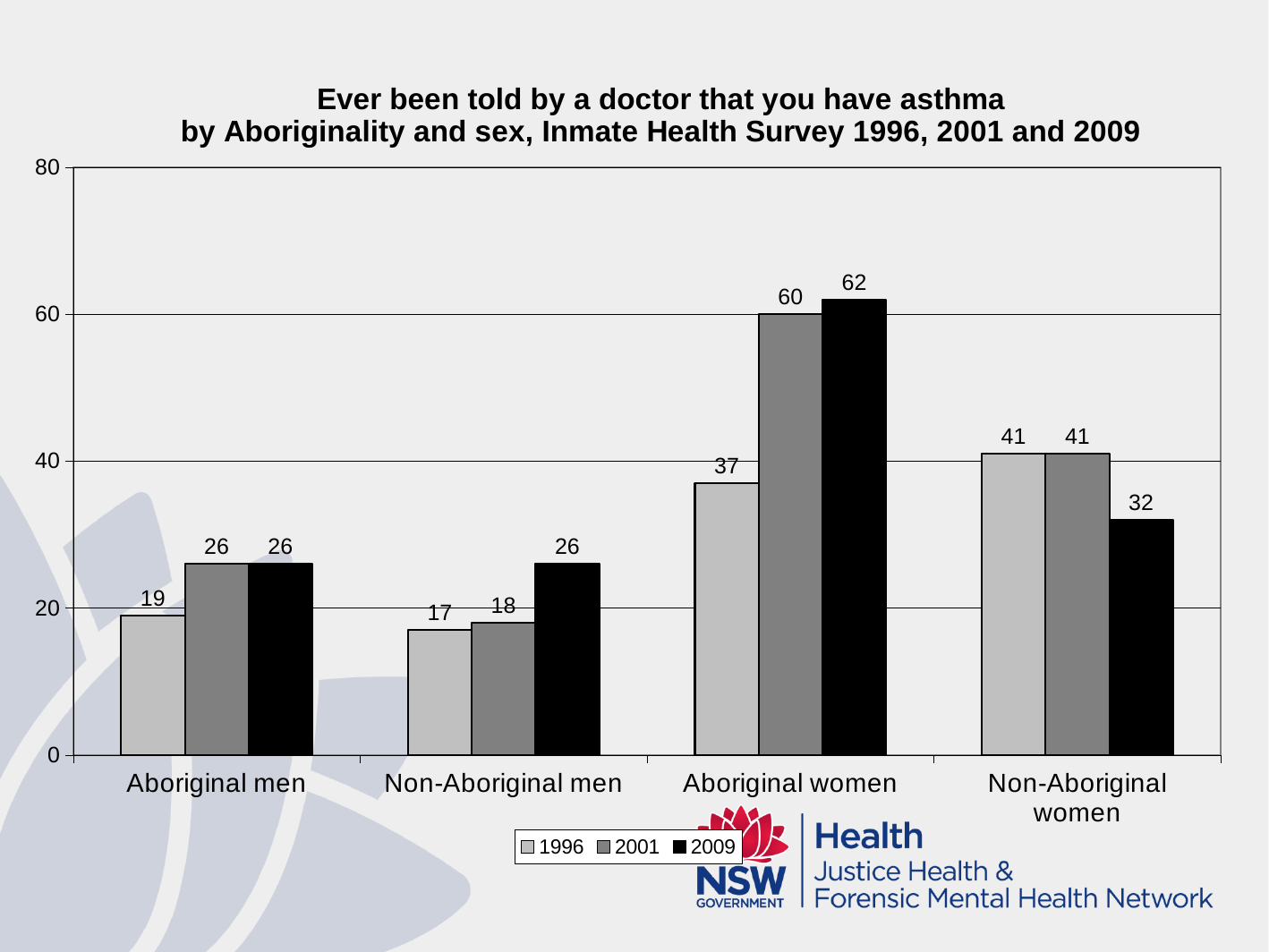
What is the value for Aboriginal women in 2009? 62 What is the value for Non-Aboriginal men in 1996? 17 How many categories are shown on the x axis? 4 Which is larger: the 2009 value for Aboriginal men or the 2009 value for Non-Aboriginal women? Non-Aboriginal women Which category has the lowest value in 1996? Non-Aboriginal men How many series does the legend list? 3 Which category has the highest value in 2001? Aboriginal women Which series is shown in black in the legend? 2009 What is the value for Non-Aboriginal women in 2009? 32 Did the value for Non-Aboriginal men rise or fall from 1996 to 2009? Rise What kind of chart is shown on the slide? Bar chart What is the difference between the 2009 values for Aboriginal women and Non-Aboriginal women? 30